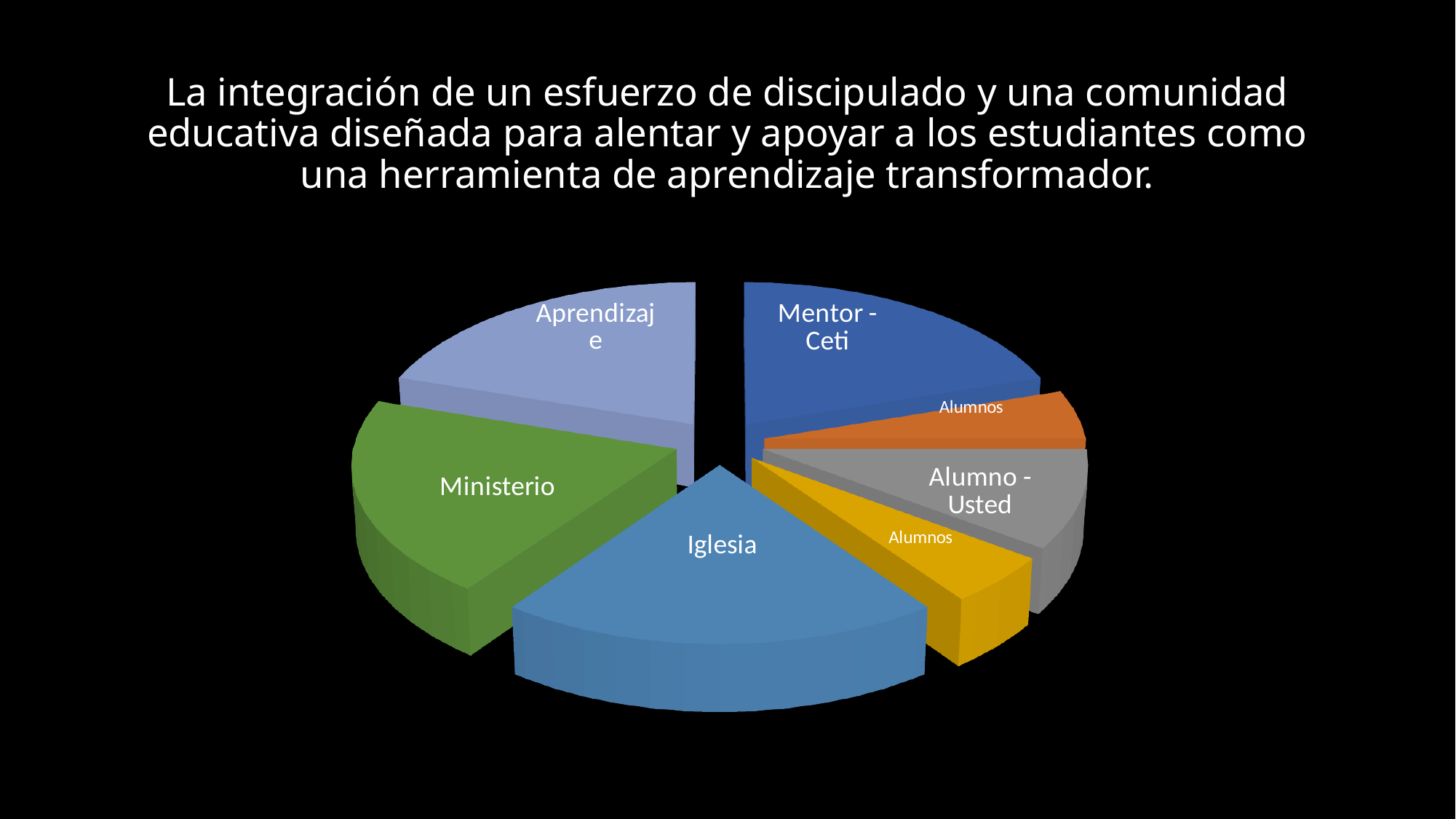
Which slice is larger, Iglesia or Alumno - Usted? Iglesia Is the pie chart drawn in 3D or flat 2D? 3D What kind of chart is shown on the slide? Pie chart How many slices in the pie chart are labelled "Alumnos"? 2 How many slices does the pie chart have? 7 Which slice is larger, Ministerio or the orange Alumnos slice? Ministerio What colour is the Ministerio slice of the pie chart? Green Which slice is larger, Mentor - Ceti or the yellow Alumnos slice? Mentor - Ceti